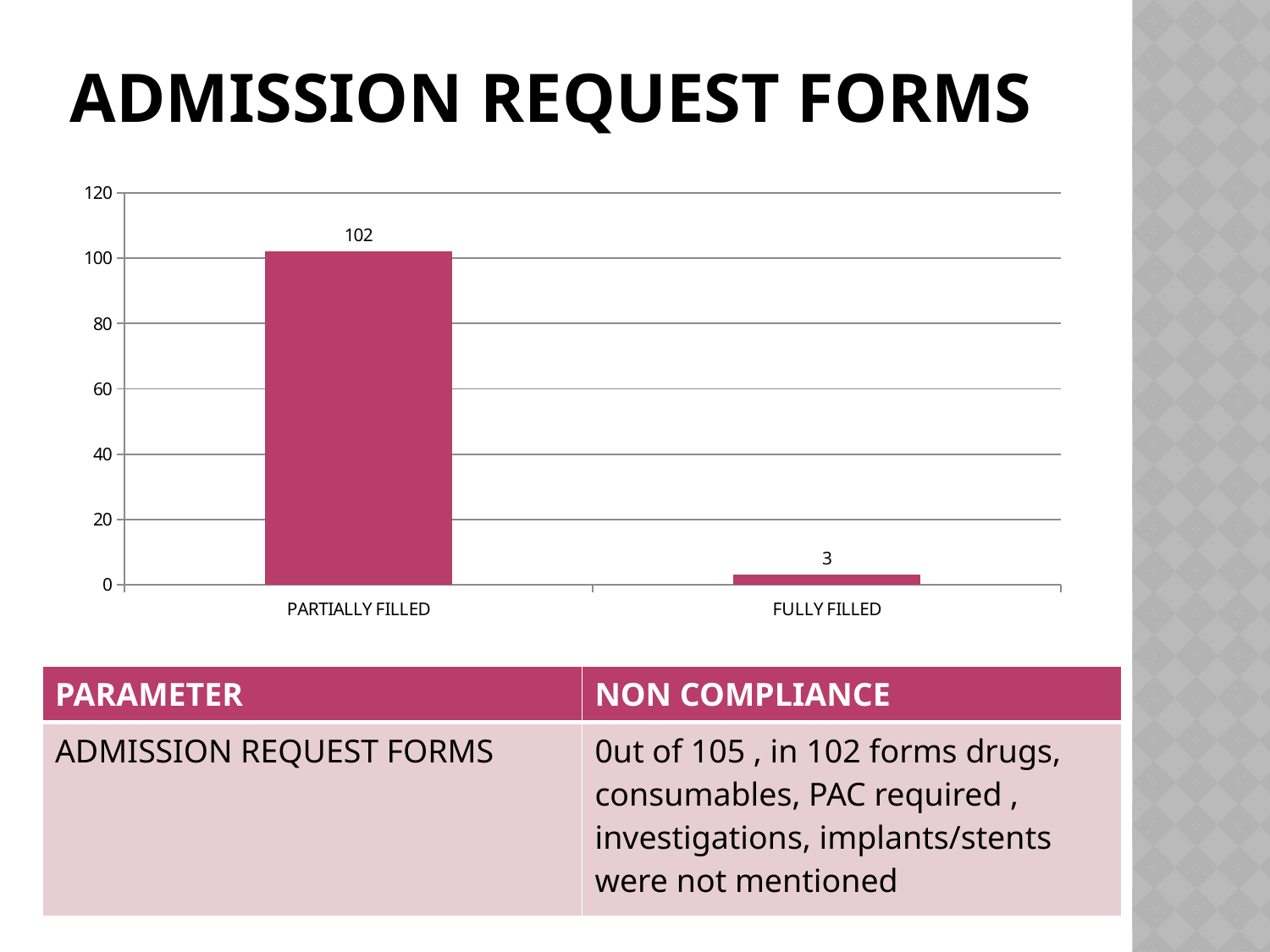
Which category has the highest value? PARTIALLY FILLED What is the total of the two bars on the chart? 105 Is the value for FULLY FILLED greater or less than 20? less Is the value for PARTIALLY FILLED greater or less than 100? greater How many categories are shown on the chart? 2 What is the value for PARTIALLY FILLED? 102 Which is larger, the value for PARTIALLY FILLED or the value for FULLY FILLED? PARTIALLY FILLED What kind of chart is shown on the slide? bar chart What is the value for FULLY FILLED? 3 What is the title of the slide containing the chart? ADMISSION REQUEST FORMS Which category has the lowest value? FULLY FILLED What is the difference between the values for PARTIALLY FILLED and FULLY FILLED? 99